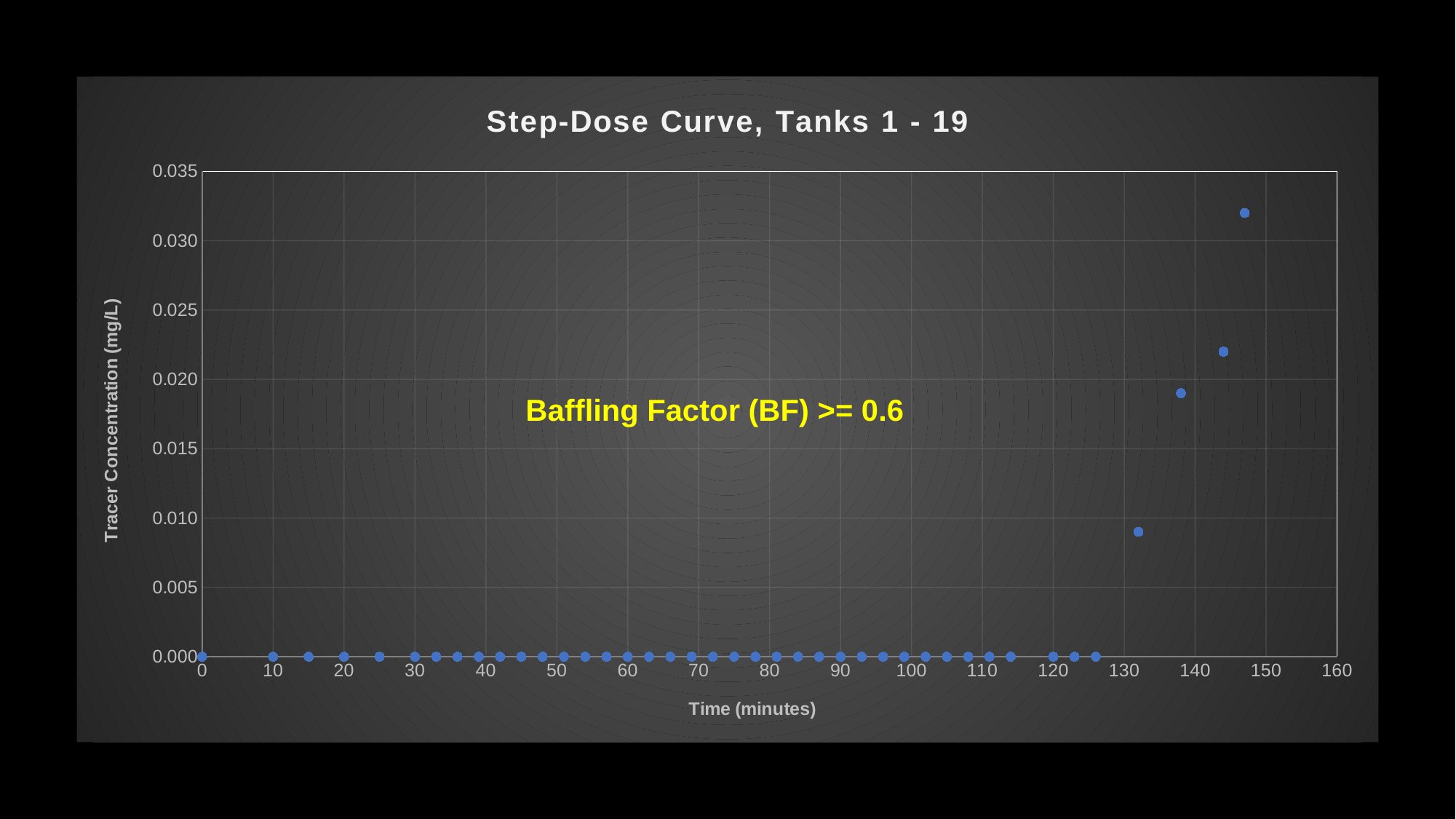
Is the value of the point at about 144 minutes greater or less than 0.020? greater What is the tracer concentration at 100 minutes? 0.000 Do the tracer concentration values rise or fall toward the right end of the x axis? rise Which point has the higher tracer concentration, the one at about 132 minutes or the one at about 147 minutes? the one at about 147 minutes Is the value of the point at about 132 minutes greater or less than 0.015? less Is the value of the highest point on the chart greater or less than 0.030? greater What kind of chart is shown on the slide? scatter chart What is the tracer concentration at 60 minutes? 0.000 What is the title of the chart? Step-Dose Curve, Tanks 1 - 19 What is the highest tick value shown on the x axis? 160 What is the label of the y axis? Tracer Concentration (mg/L)